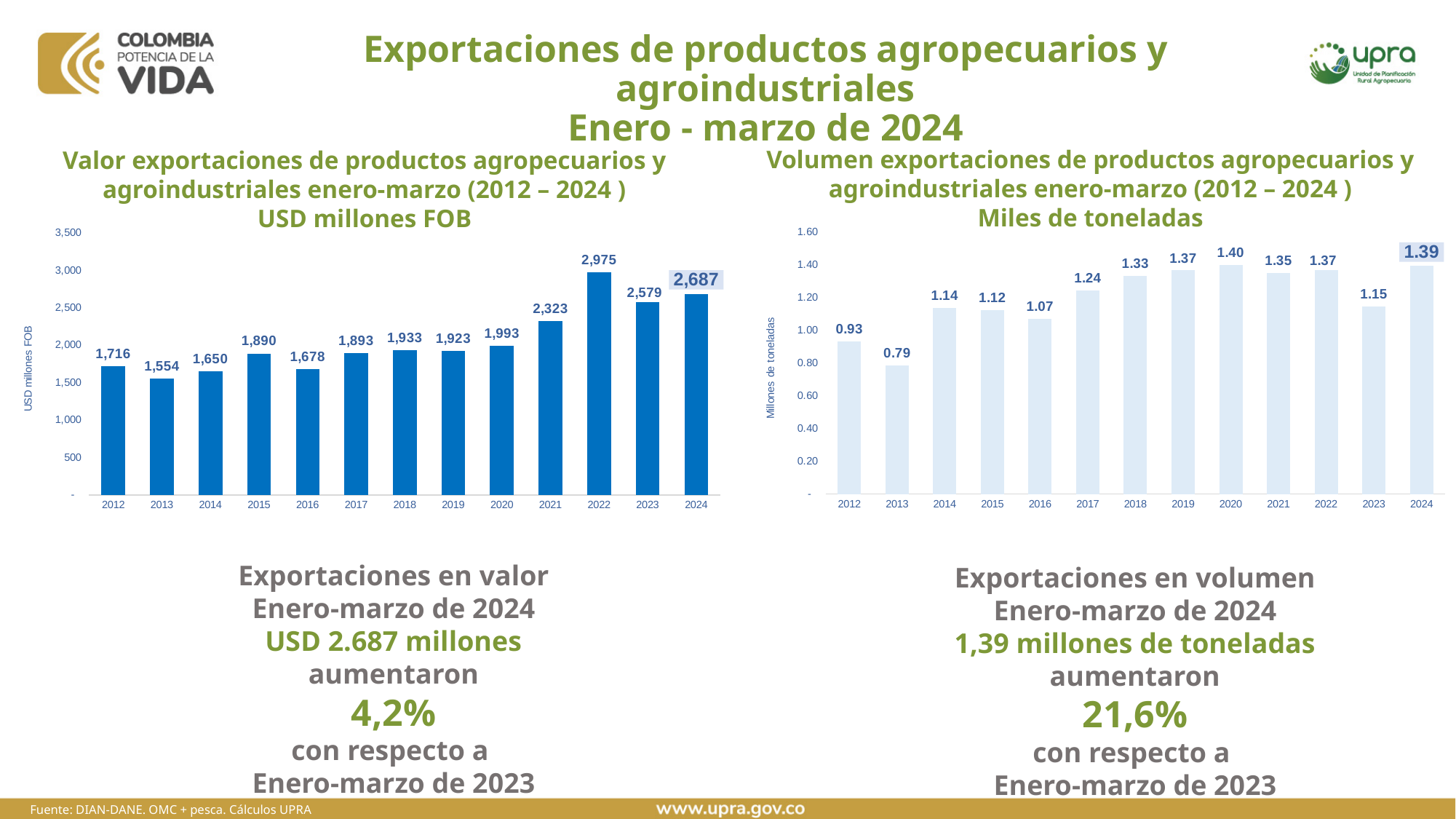
In the right chart (Volumen exportaciones), which year has the highest value? 2020 In the left chart (Valor exportaciones), what is the value for 2022? 2,975 In the left chart (Valor exportaciones), which year has the highest value? 2022 What kind of chart is the left chart (Valor exportaciones)? Bar chart In the right chart (Volumen exportaciones), is the value for 2012 greater or less than 1.00? less In the left chart (Valor exportaciones), which year has the lowest value? 2013 In the left chart (Valor exportaciones), how many years are plotted? 13 In the right chart (Volumen exportaciones), what is the difference between the 2024 value and the 2023 value? 0.24 In the left chart (Valor exportaciones), what is the difference between the 2024 value and the 2023 value? 108 In the right chart (Volumen exportaciones), what is the value for 2013? 0.79 What is the y-axis label of the left chart (Valor exportaciones)? USD millones FOB In the right chart (Volumen exportaciones), which is larger, the value for 2023 or the value for 2024? 2024